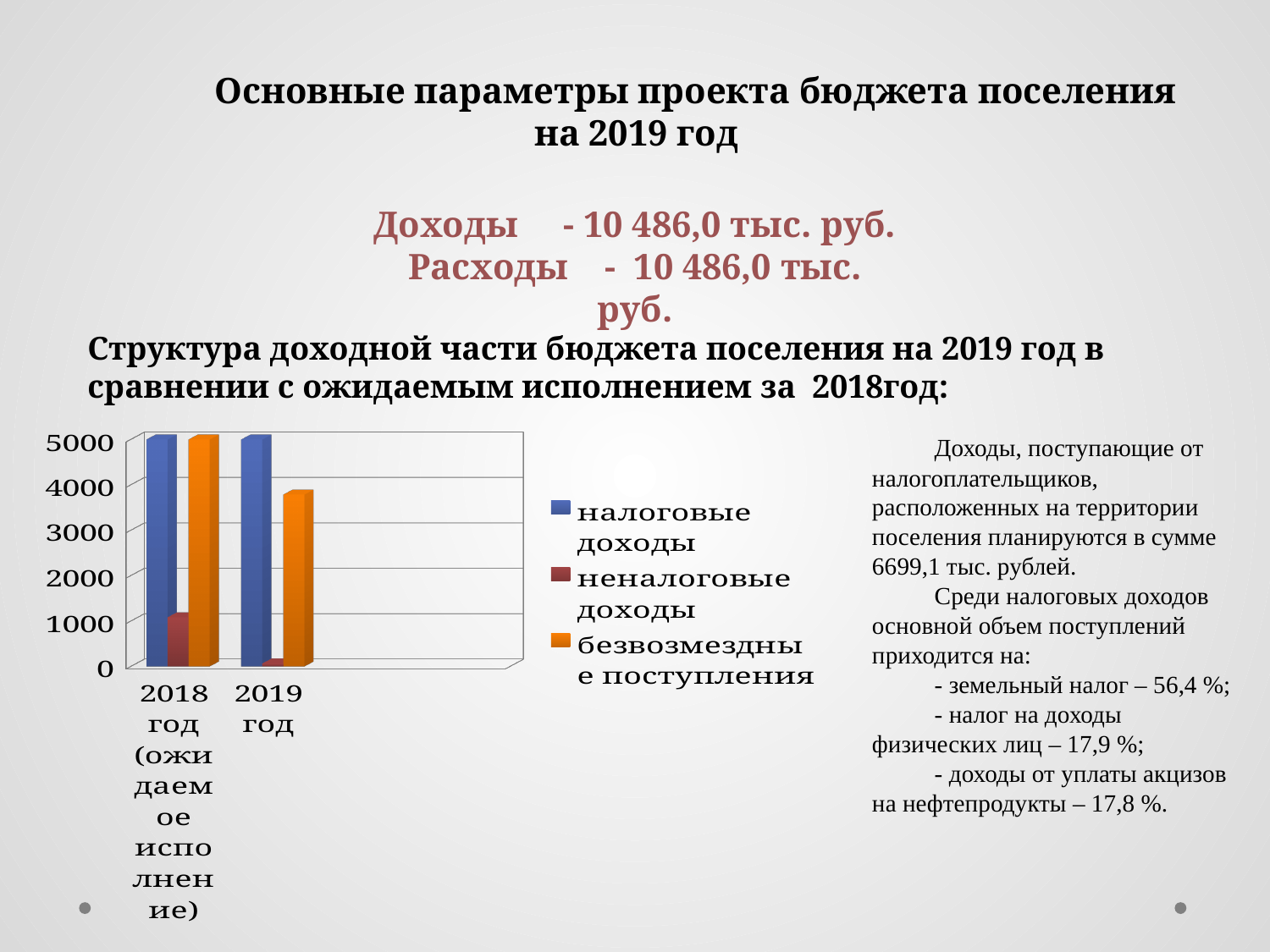
Do the values for неналоговые доходы rise or fall from 2018 год to 2019 год? fall Is the value for безвозмездные поступления in 2019 год greater or less than 3000? greater Is the value for неналоговые доходы in 2018 год greater or less than 2000? less Is the value for неналоговые доходы in 2019 год greater or less than 1000? less Which series is shown in orange in the chart legend? безвозмездные поступления How many categories (years) are shown on the x axis of the chart? 2 How many series does the chart legend list? 3 What kind of chart is shown on the slide? bar chart Which is larger: безвозмездные поступления in 2018 год or in 2019 год? 2018 год Which series has the lowest value in 2019 год? неналоговые доходы